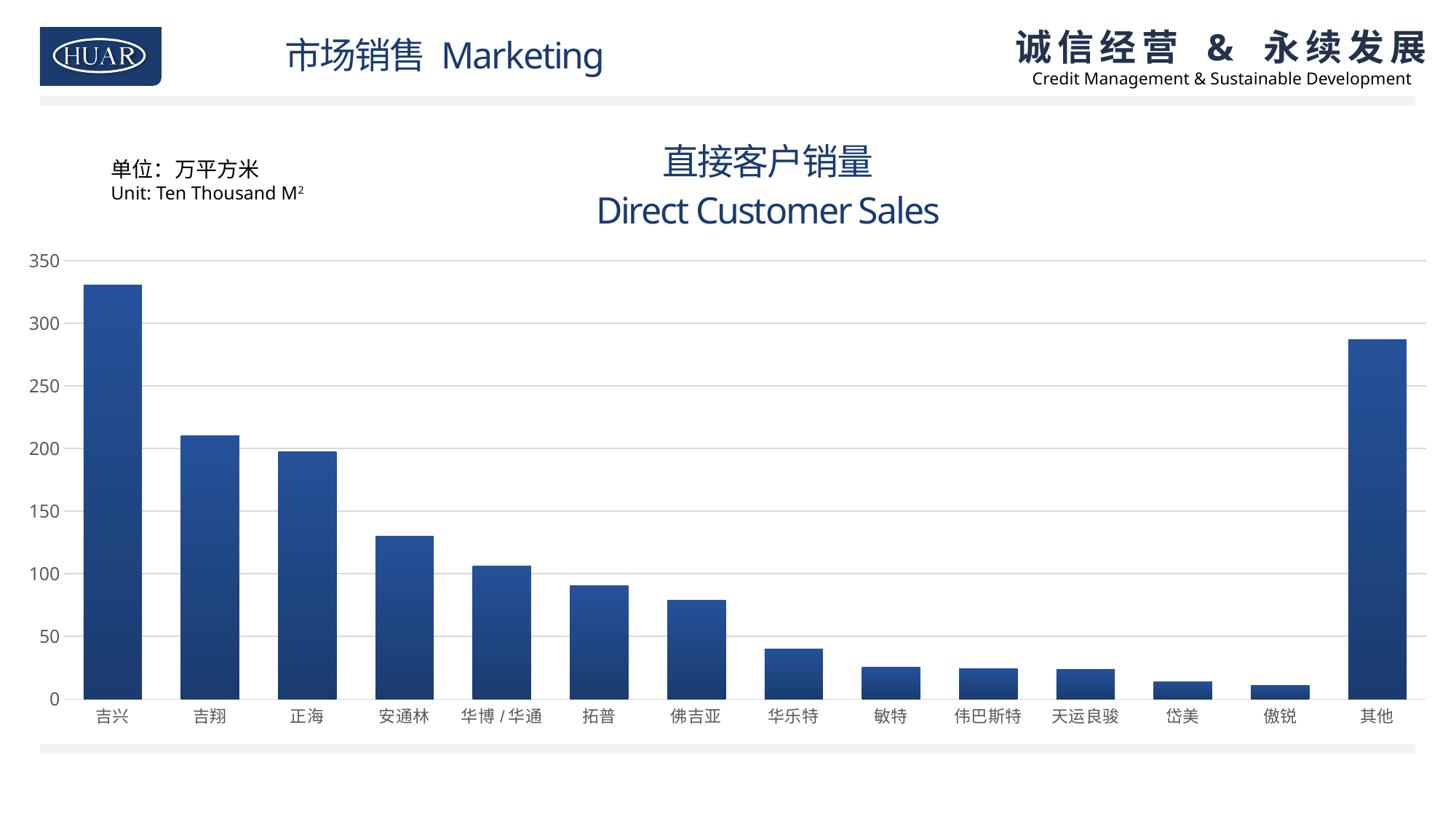
Which is larger, the value for 拓普 or the value for 佛吉亚? 拓普 Is the value for 其他 greater or less than 300? less What kind of chart is shown on the slide? bar chart Is the value for 吉兴 greater or less than 300? greater Which category has the lowest bar in the chart? 傲锐 How many customer categories are shown on the x axis of the chart? 14 Is the value for 安通林 greater or less than 100? greater What unit is stated for the values in the chart? Ten Thousand M² (万平方米) Which is larger, the value for 吉翔 or the value for 其他? 其他 Which category has the highest bar in the chart? 吉兴